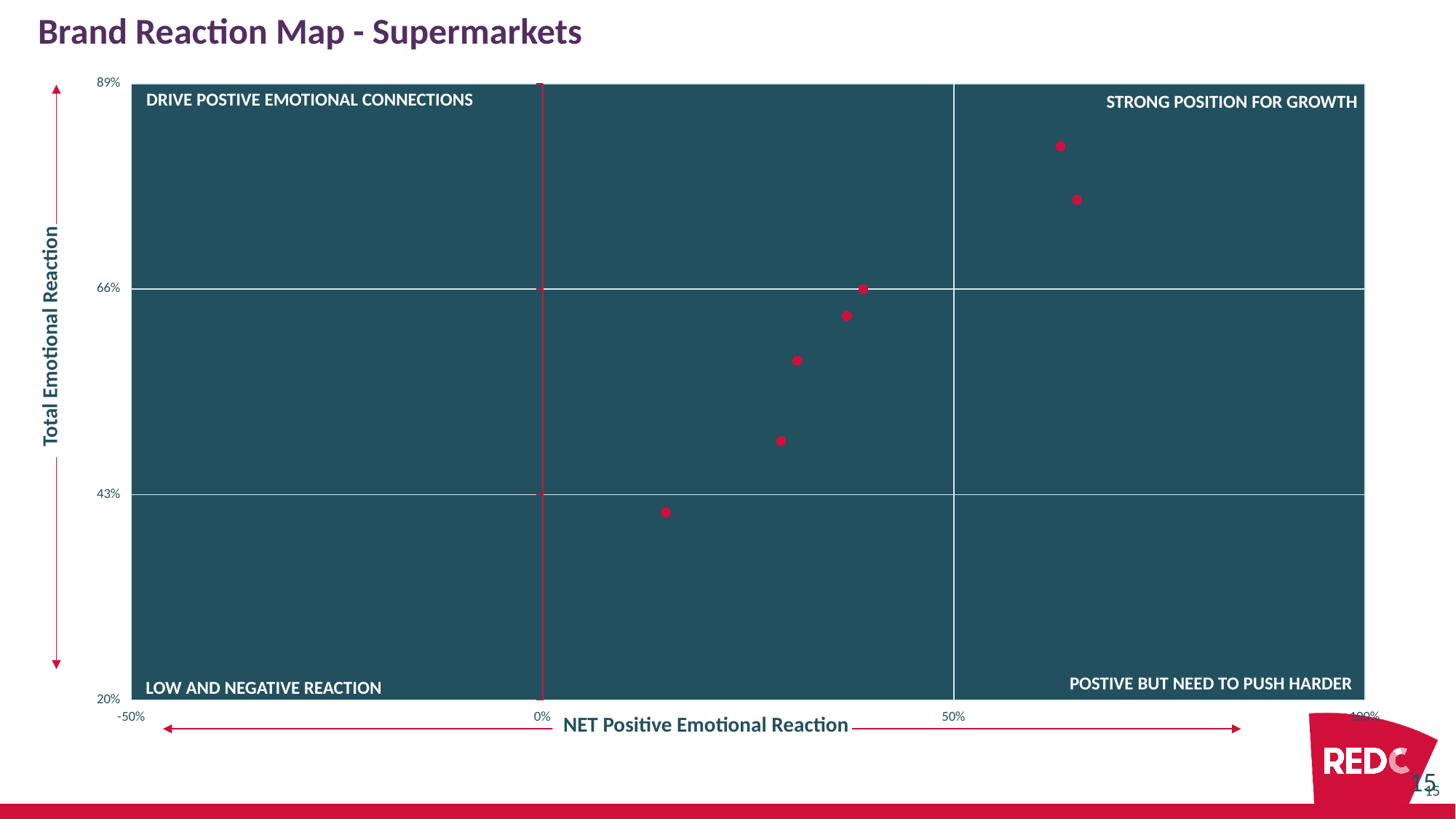
Is the Total Emotional Reaction of the highest plotted point greater or less than 66%? greater How many plotted points lie below the 43% gridline on the Total Emotional Reaction axis? 1 How many plotted points lie between 0% and 50% on the NET Positive Emotional Reaction axis? 5 Is the NET Positive Emotional Reaction of every plotted point greater or less than 0%? greater Is the Total Emotional Reaction of the lowest plotted point greater or less than 43%? less How many plotted points lie to the right of the 50% line on the NET Positive Emotional Reaction axis? 2 What label appears in the top-right corner of the chart area? STRONG POSITION FOR GROWTH What kind of chart is shown on the slide? scatter chart As NET Positive Emotional Reaction increases along the x axis, do the plotted points generally rise or fall in Total Emotional Reaction? rise What is the title of the horizontal axis? NET Positive Emotional Reaction